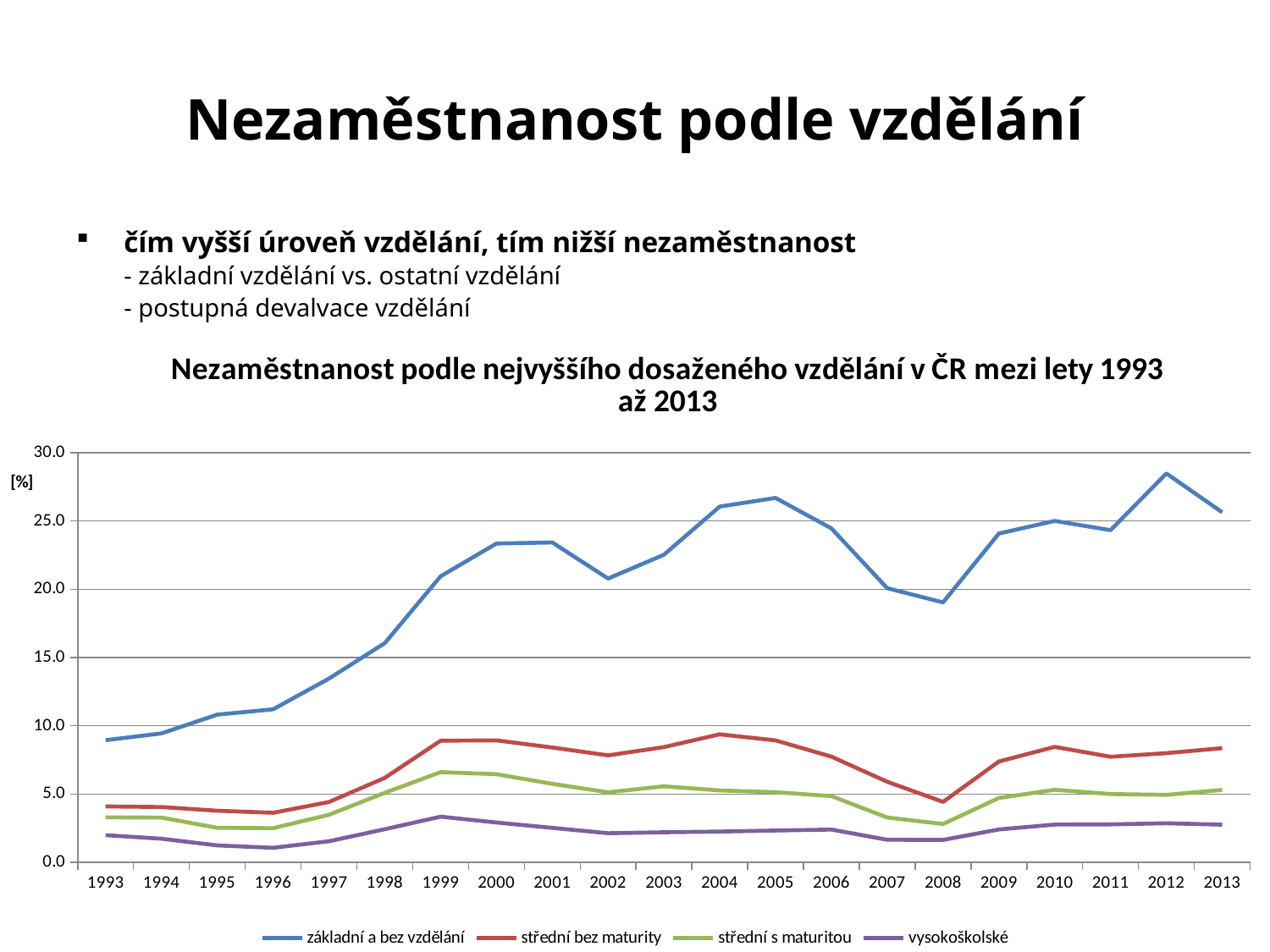
How many years are plotted along the x axis? 21 How many series does the legend list? 4 Which series has the lowest values across the whole period? vysokoškolské Is the value for 'vysokoškolské' in 2008 greater or less than 5.0? less What kind of chart is shown on the slide? line chart Does the 'základní a bez vzdělání' series rise or fall between 1993 and 1999? rise Which is larger for 'základní a bez vzdělání': the value in 2008 or the value in 2012? 2012 In which year is the 'základní a bez vzdělání' series at its lowest value? 1993 Is the value for 'základní a bez vzdělání' in 1993 greater or less than 10.0? less In which year does the 'základní a bez vzdělání' series reach its highest value? 2012 Which series has the highest values across the whole period? základní a bez vzdělání Is the value for 'základní a bez vzdělání' in 2012 greater or less than 25.0? greater